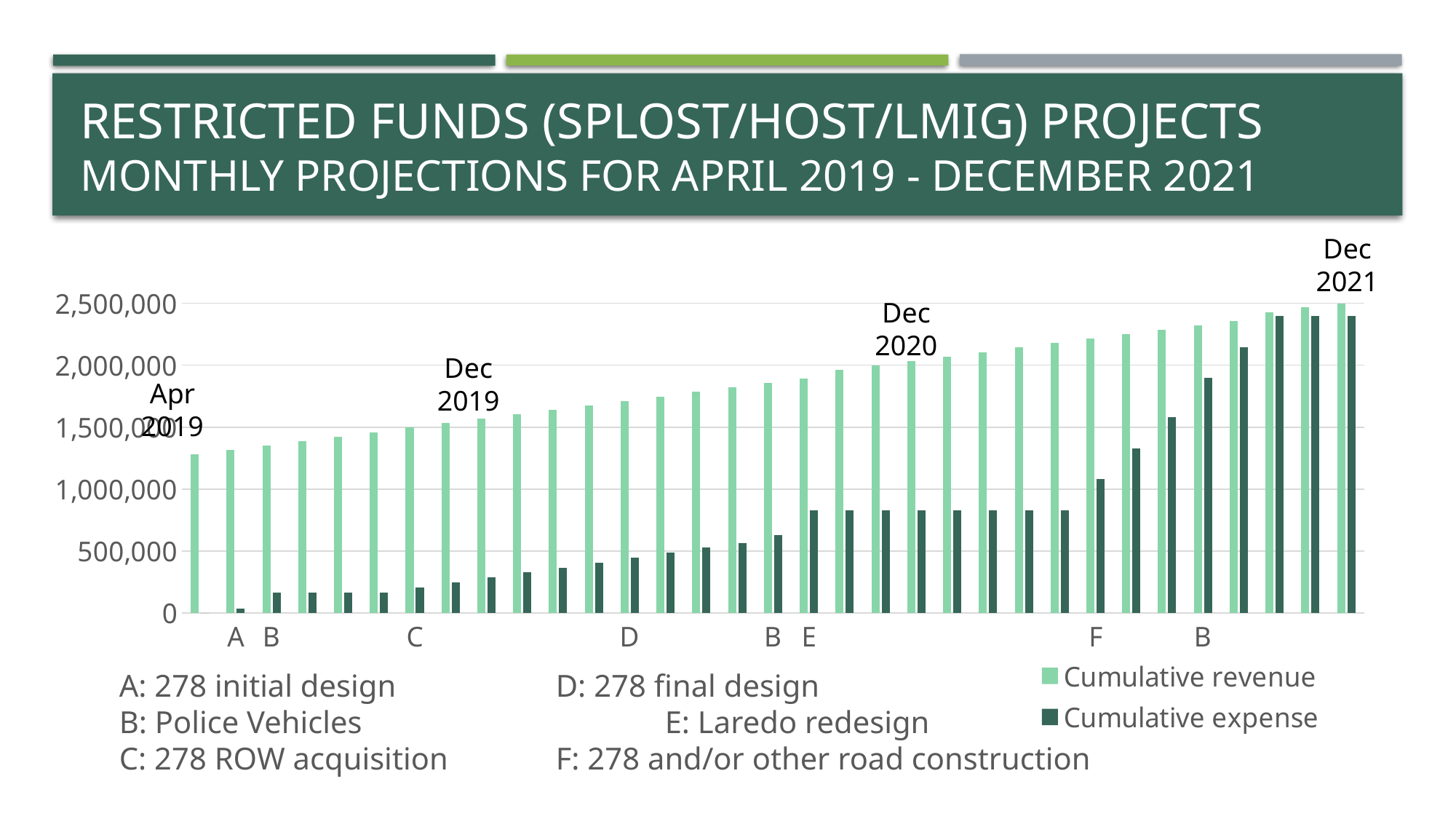
Does cumulative revenue rise or fall from April 2019 to December 2021? Rise Which two series are shown in the legend? Cumulative revenue and Cumulative expense According to the key below the chart, what does the letter B stand for? Police Vehicles Is the cumulative expense for Apr 2019 greater or less than 500,000? less In Apr 2019, which is larger: cumulative revenue or cumulative expense? Cumulative revenue How many series does the legend list? 2 Which month has the highest cumulative revenue? Dec 2021 Is the cumulative revenue for Dec 2021 greater or less than 2,000,000? greater Is the cumulative revenue for Dec 2019 greater or less than 2,000,000? less What type of chart is shown on the slide? Bar chart Which month has the lowest cumulative revenue? Apr 2019